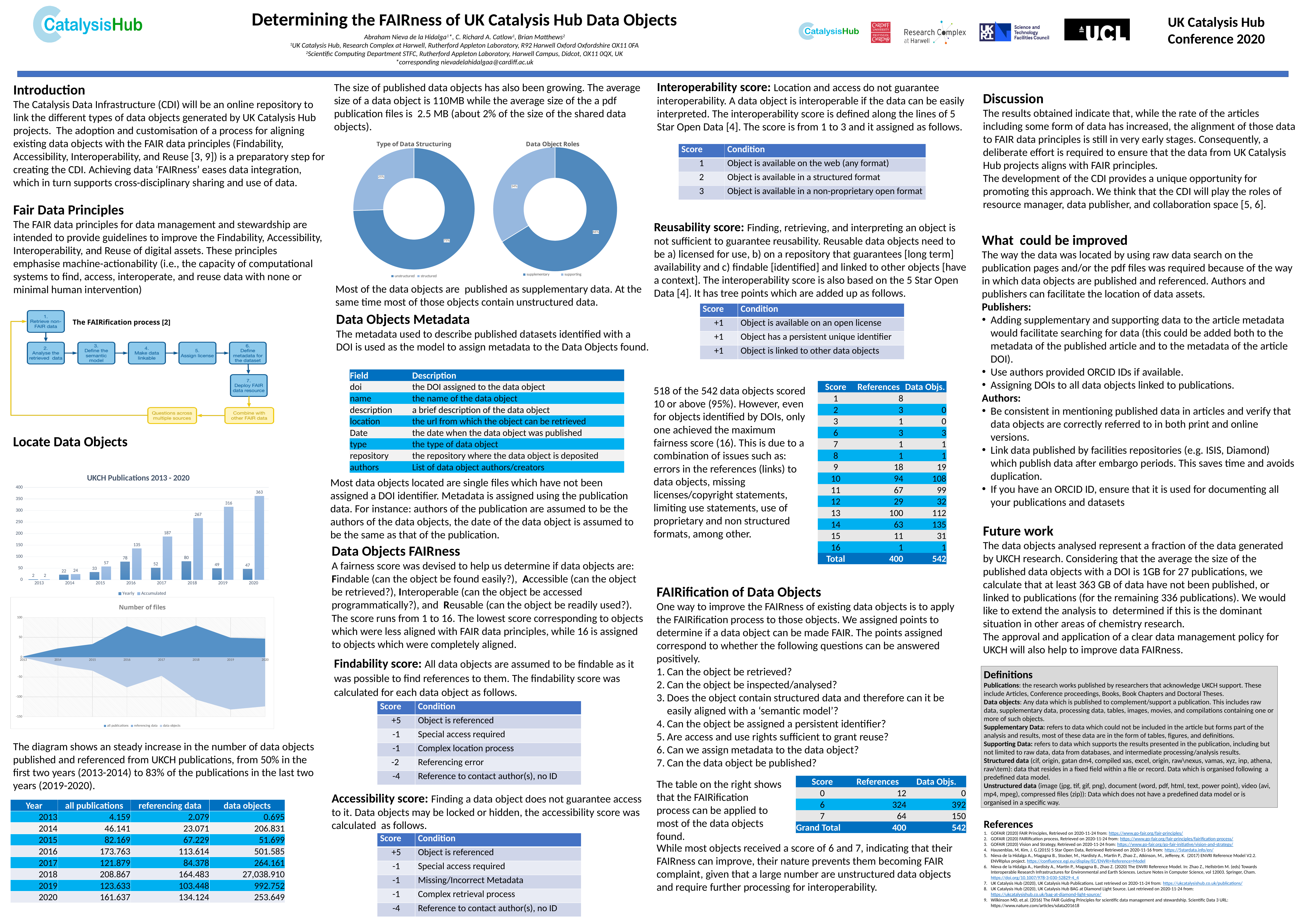
In the 'UKCH Publications 2013 - 2020' chart, what is the Accumulated value for 2018? 267 What kind of chart is 'UKCH Publications 2013 - 2020'? bar chart In the 'UKCH Publications 2013 - 2020' chart, which year has the lowest Yearly value? 2013 In the 'UKCH Publications 2013 - 2020' chart, does the Accumulated series rise or fall from 2013 to 2020? rise What are the two legend entries of the 'Data Object Roles' donut chart? supplementary, supporting In the 'UKCH Publications 2013 - 2020' chart, how many years are shown on the x axis? 8 In the 'UKCH Publications 2013 - 2020' chart, what is the Accumulated value for 2020? 363 In the 'UKCH Publications 2013 - 2020' chart, what is the Yearly value for 2016? 78 In the 'UKCH Publications 2013 - 2020' chart, which year has the highest Yearly value? 2018 How many series does the legend of the 'UKCH Publications 2013 - 2020' chart list? 2 In the 'UKCH Publications 2013 - 2020' chart, is the Yearly value for 2017 larger or the Yearly value for 2019? 2017 In the 'UKCH Publications 2013 - 2020' chart, what is the difference between the Accumulated values for 2019 and 2018? 49